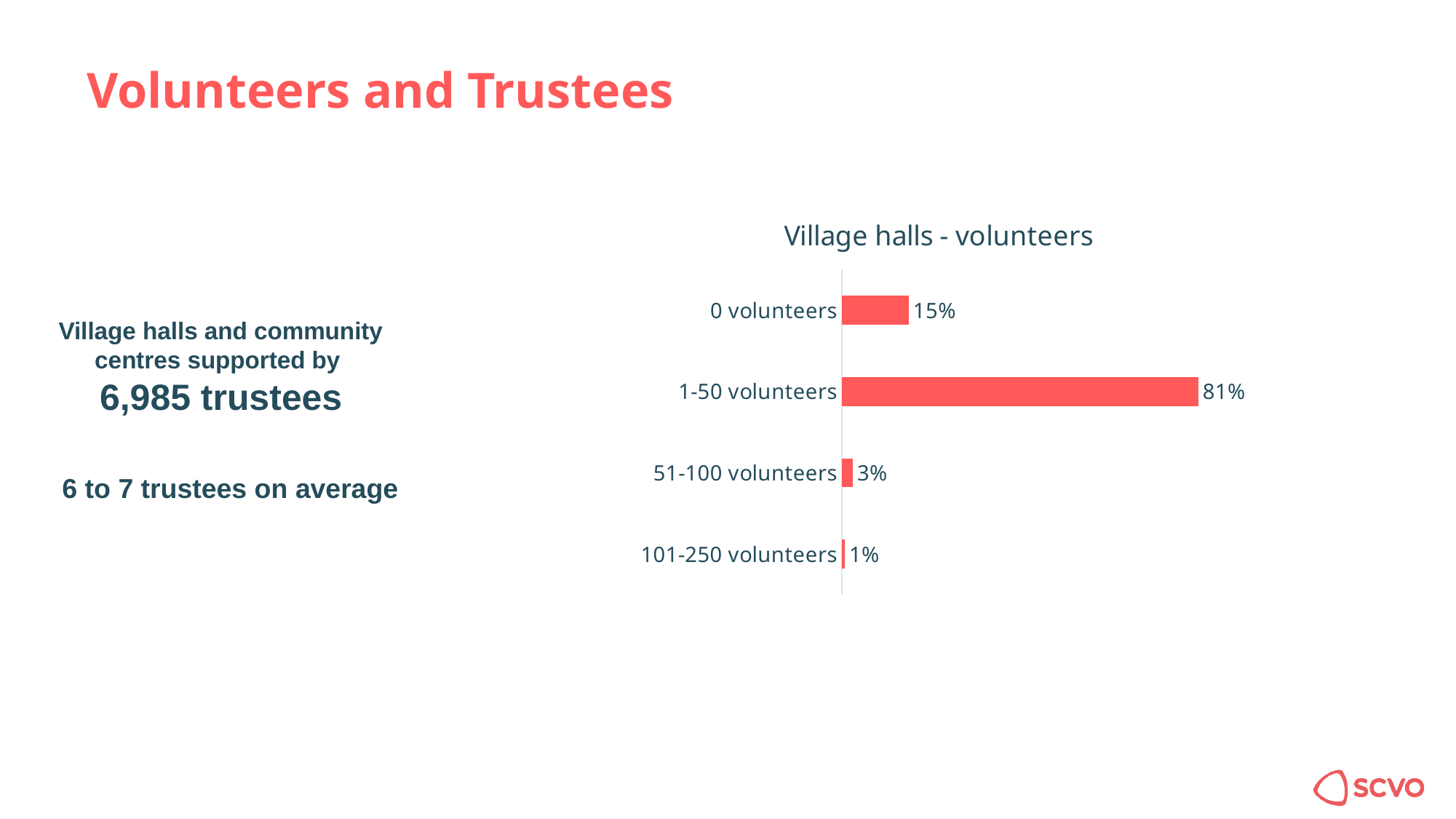
Which volunteer category has the highest percentage? 1-50 volunteers What percentage of village halls have 0 volunteers? 15% What is the difference in percentage points between the 1-50 volunteers and 0 volunteers categories? 66 What type of chart is used to show the village halls volunteers data? Bar chart What percentage of village halls have 1-50 volunteers? 81% What is the difference in percentage points between the 51-100 volunteers and 101-250 volunteers categories? 2 What percentage of village halls have 51-100 volunteers? 3% How many volunteer categories are shown in the chart? 4 Which is larger: the percentage for 0 volunteers or for 51-100 volunteers? 0 volunteers What percentage of village halls have 101-250 volunteers? 1% What is the title of the chart? Village halls - volunteers Which volunteer category has the lowest percentage? 101-250 volunteers